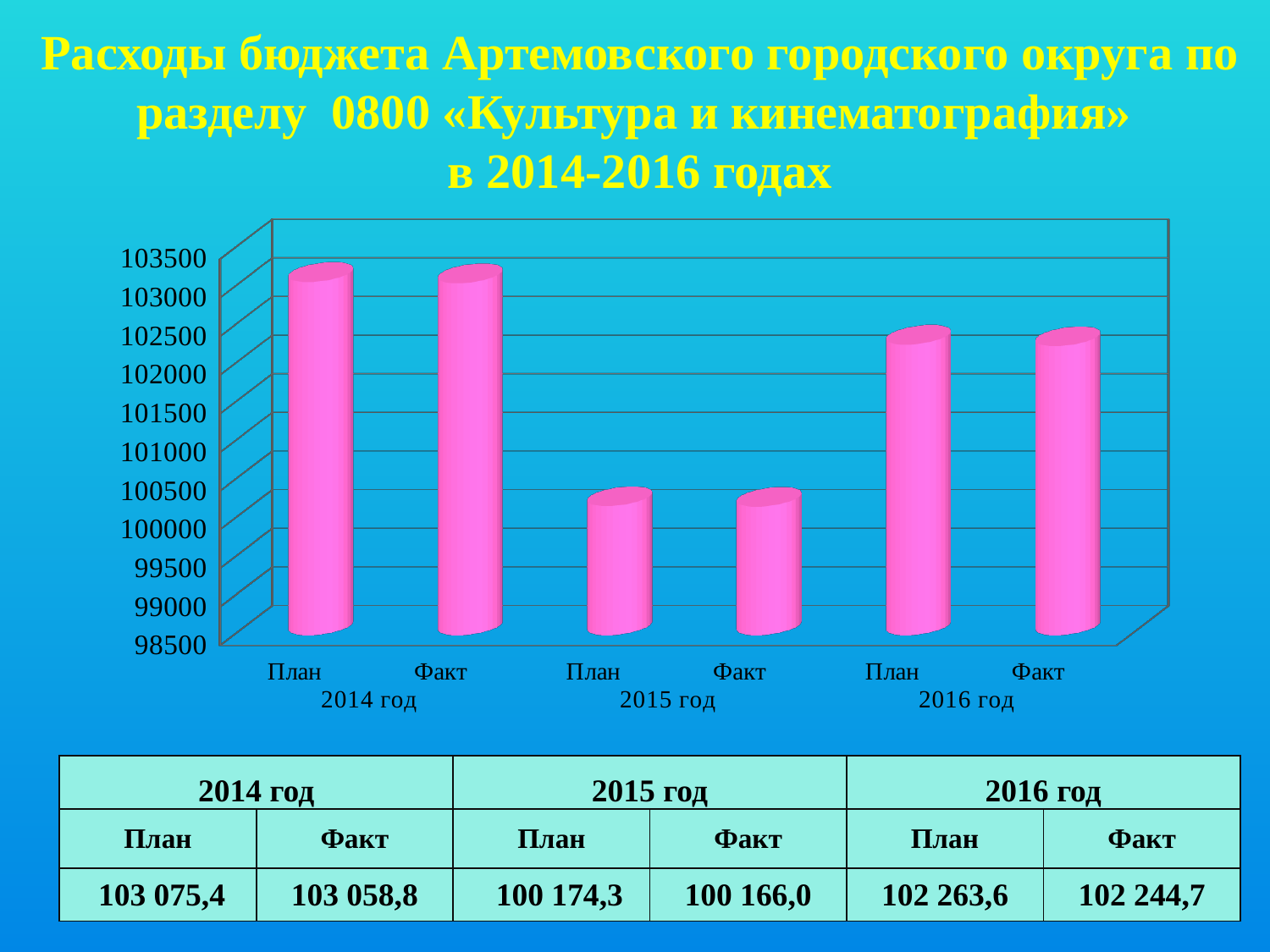
What is the value for План in 2014 год? 103 075,4 Which bar has the highest value? План 2014 год What is the difference between План and Факт in 2014 год? 16,6 Do the values fall or rise from 2014 год to 2015 год? fall Which is larger, План in 2014 год or План in 2016 год? План in 2014 год What kind of chart is shown on the slide? bar chart What is the value for План in 2016 год? 102 263,6 How many bars are plotted in the chart? 6 What is the value for Факт in 2015 год? 100 166,0 Which bar has the lowest value? Факт 2015 год Is the value for План in 2015 год greater or less than 100500? less What is the difference between План and Факт in 2016 год? 18,9